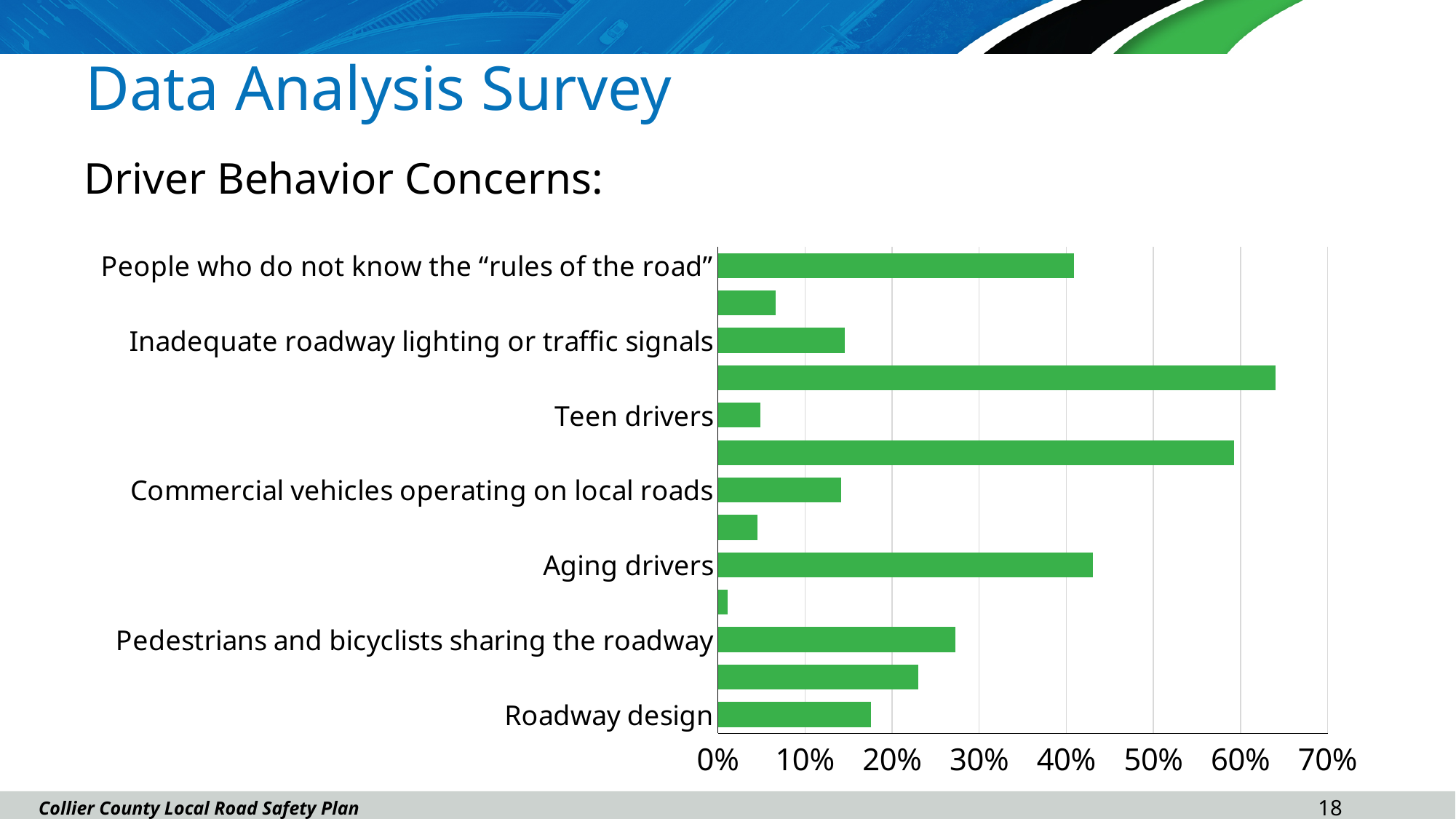
What is the highest value shown on the chart's horizontal axis? 70% Is the value for "Aging drivers" greater or less than 30%? greater Which has the larger value: "Aging drivers" or "Teen drivers"? Aging drivers How many bars are plotted in the chart? 13 Is the value for "Commercial vehicles operating on local roads" greater or less than 20%? less What kind of chart is shown on the slide? Bar chart Is the value for "Inadequate roadway lighting or traffic signals" greater or less than 20%? less Which has the larger value: "Pedestrians and bicyclists sharing the roadway" or "Roadway design"? Pedestrians and bicyclists sharing the roadway